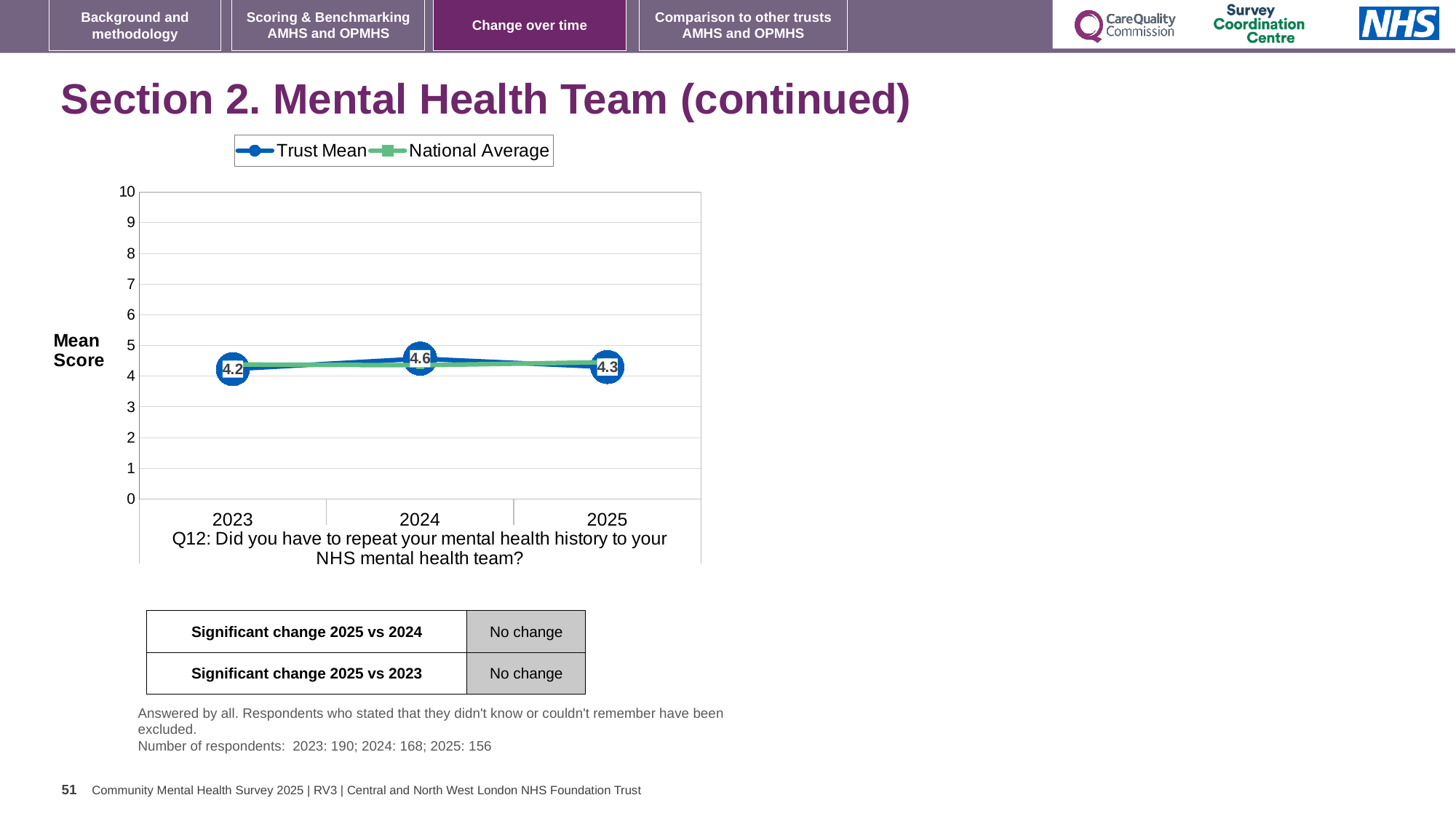
What is the label on the y axis of the chart? Mean Score In which year is the Trust Mean lowest? 2023 What is the Trust Mean score for 2023? 4.2 What is the Trust Mean score for 2024? 4.6 In which year is the Trust Mean highest? 2024 How many series does the chart legend list? 2 What kind of chart is shown on the slide? Line chart What is the difference between the Trust Mean in 2024 and in 2023? 0.4 How many years are shown on the x axis of the chart? 3 Which year has the larger Trust Mean, 2023 or 2025? 2025 What is the Trust Mean score for 2025? 4.3 Is the National Average value for 2024 greater or less than 5? less